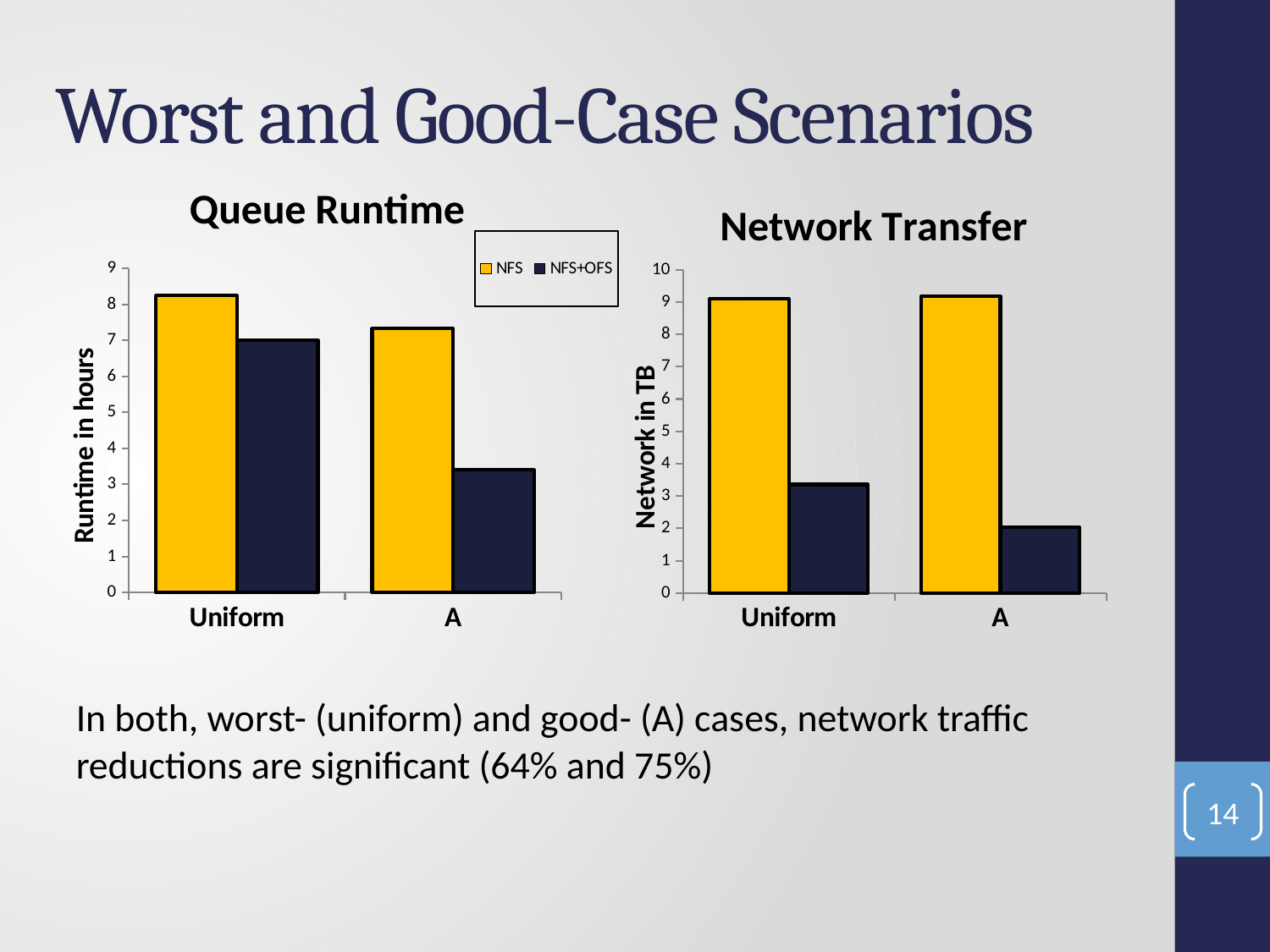
What is the y-axis label of the Network Transfer chart? Network in TB In the Network Transfer chart, which category has the lowest NFS+OFS value? A How many categories are shown on the x axis of the Network Transfer chart? 2 What kind of chart is the Queue Runtime chart? bar chart In the Queue Runtime chart, is the NFS value for Uniform greater or less than 8? greater How many series does the legend on the Queue Runtime chart list? 2 In the Queue Runtime chart, which is larger for category A: NFS or NFS+OFS? NFS In the Network Transfer chart, is the NFS value for Uniform greater or less than 8? greater In the Queue Runtime chart, which category has the highest NFS+OFS value? Uniform In the Queue Runtime chart, is the NFS+OFS value for A greater or less than 4? less Which series is shown in yellow in the Queue Runtime chart? NFS